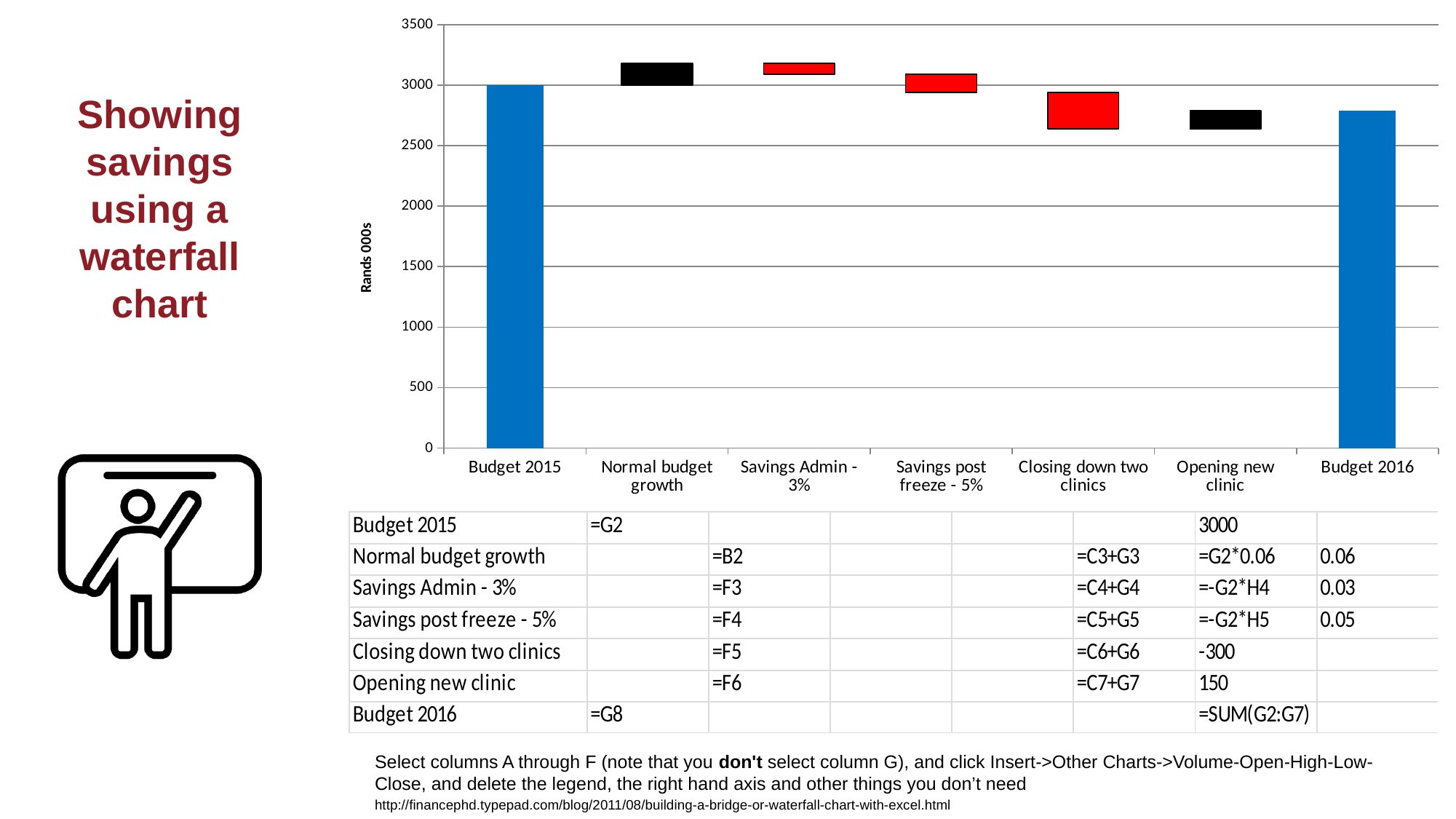
How many categories are shown on the x axis of the chart? 7 Is the value for Budget 2016 greater or less than 3000? less Which category has the tallest bar in the chart? Budget 2015 Is the value for Budget 2016 greater or less than 2500? greater What is the value of the Budget 2015 bar? 3000 How many bars in the chart are coloured red? 3 Is the top of the Closing down two clinics bar greater or less than 3000? less Does the budget rise or fall from Budget 2015 to Budget 2016? fall What is the highest value shown on the y axis? 3500 What kind of chart is shown on the slide? waterfall chart What is the label on the y axis of the chart? Rands 000s Which is larger, the Budget 2015 bar or the Budget 2016 bar? Budget 2015